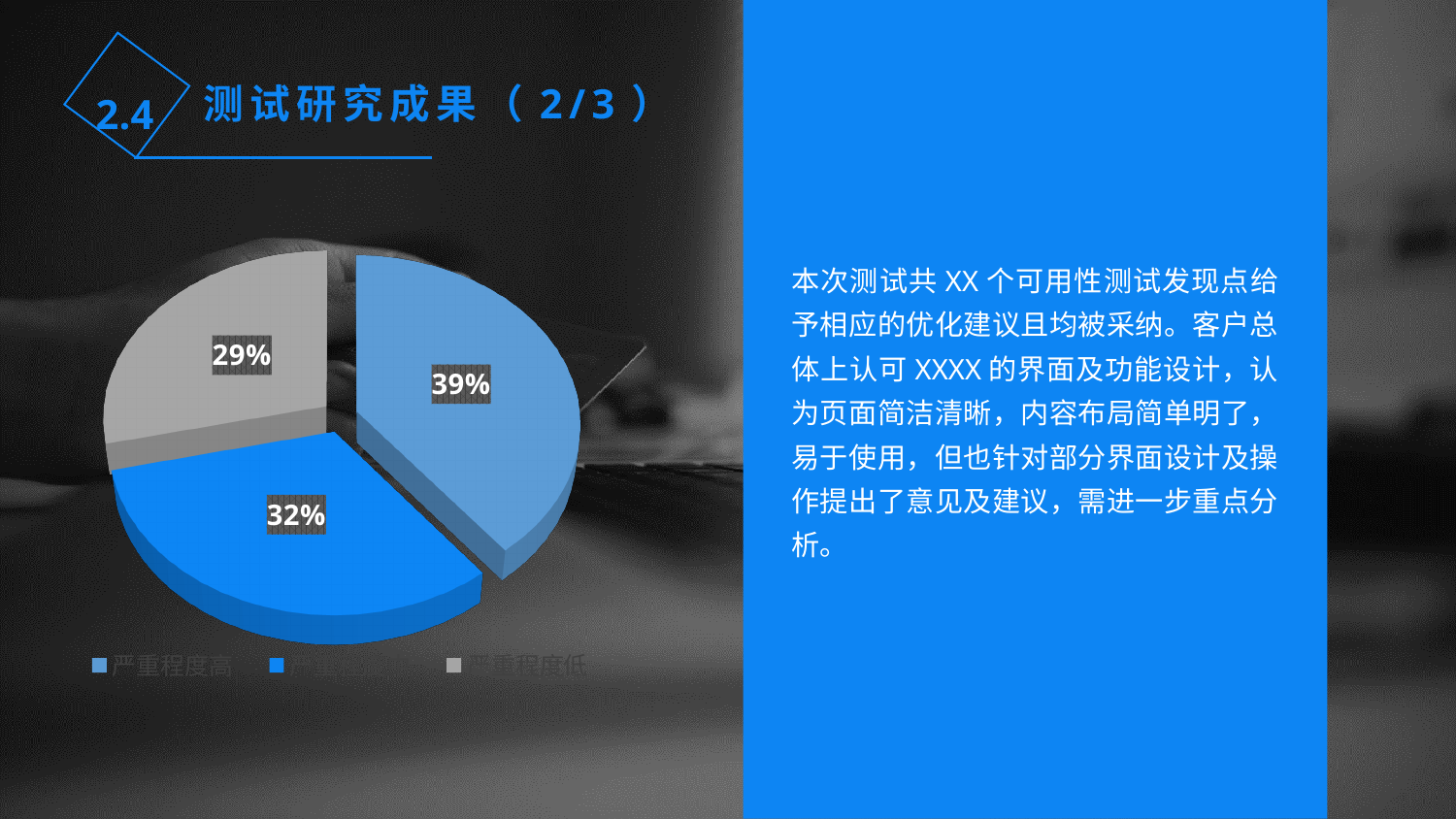
What percentage does the 严重程度低 slice represent in the pie chart? 29% How many slices does the pie chart have? 3 Which slice is larger, 严重程度高 or 严重程度低? 严重程度高 Which category has the largest slice in the pie chart? 严重程度高 Which category has the smallest slice in the pie chart? 严重程度低 How many entries does the chart legend list? 3 What kind of chart is shown on the slide? Pie chart What percentage is shown on the bright blue slice at the bottom of the pie chart? 32% What is the difference in percentage points between the 39% slice and the 32% slice? 7 percentage points What percentage does the 严重程度高 slice represent in the pie chart? 39% What colour is the 严重程度低 slice in the pie chart? Gray What is the difference in percentage points between the 严重程度高 slice and the 严重程度低 slice? 10 percentage points